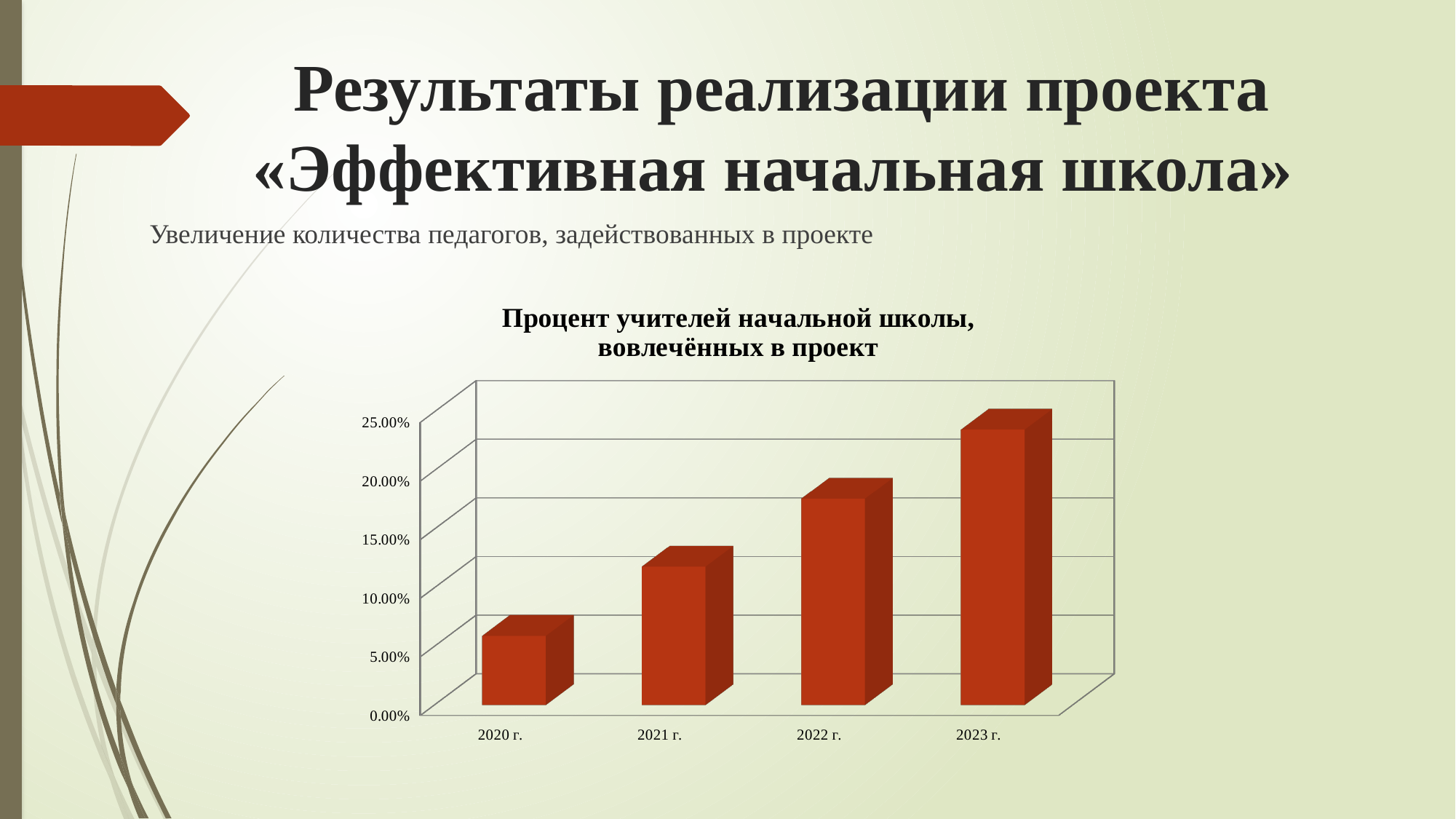
Which is larger, the value for 2021 г. or the value for 2022 г.? 2022 г. Do the values rise or fall from 2020 г. to 2023 г.? rise What is the highest value shown on the chart's vertical axis? 25.00% Is the value for 2023 г. greater or less than 20.00%? greater Is the value for 2021 г. greater or less than 10.00%? greater How many years (categories) are shown on the x axis of the chart? 4 What is the title of the chart? Процент учителей начальной школы, вовлечённых в проект Is the value for 2022 г. greater or less than 15.00%? greater Which year has the highest percentage of primary school teachers involved in the project? 2023 г. Which year has the lowest percentage of primary school teachers involved in the project? 2020 г. What kind of chart is shown on the slide? bar chart